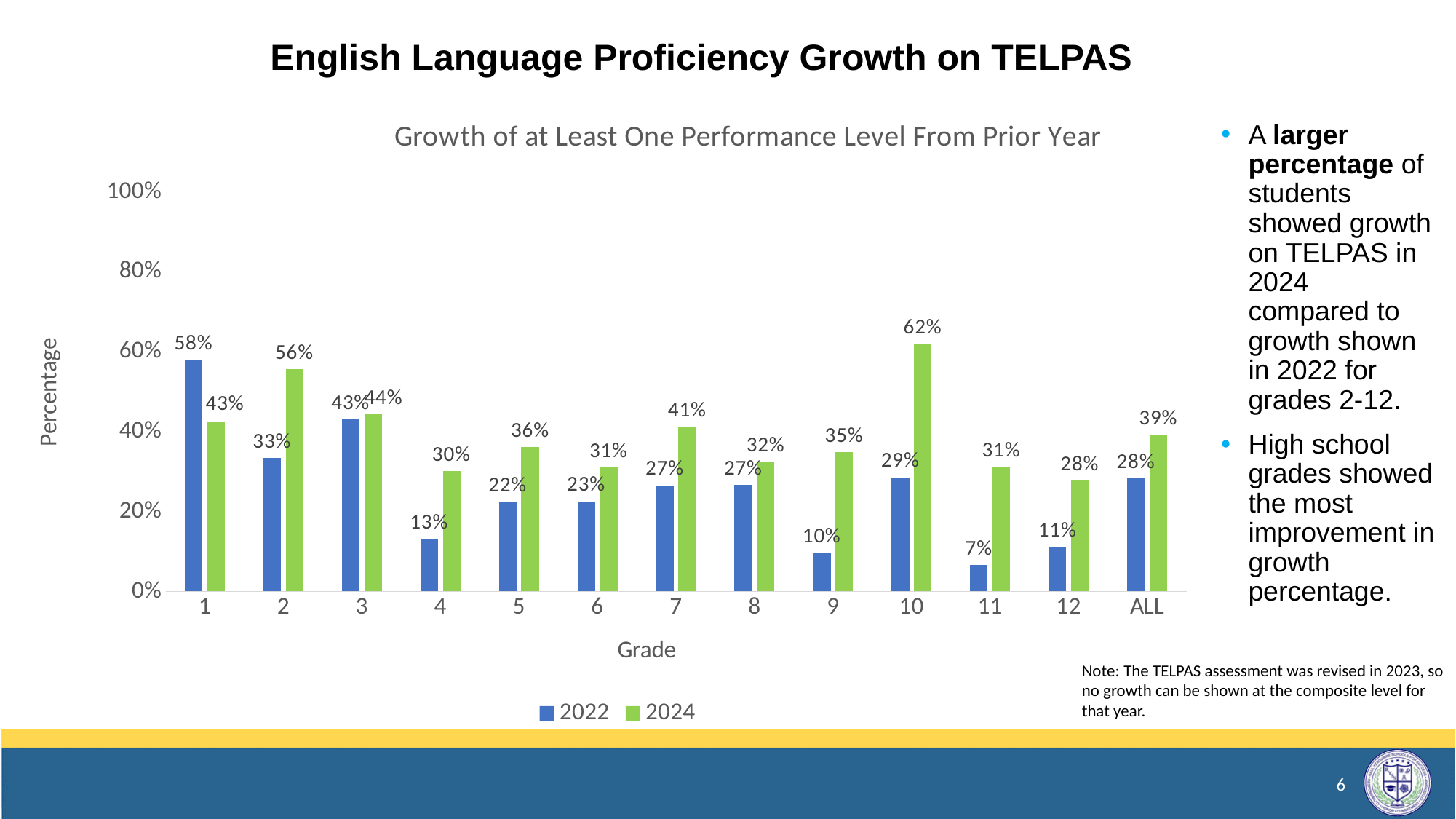
Which is larger for grade 1, the 2022 value or the 2024 value? 2022 Which grade has the highest 2024 value? 10 How many series does the legend list? 2 What is the 2024 value for grade 10? 62% What kind of chart is shown? Bar chart What is the title of the chart? Growth of at Least One Performance Level From Prior Year What is the difference between the 2024 and 2022 values for grade 10? 33 percentage points What is the 2024 value for the ALL category? 39% What is the 2022 value for grade 4? 13% Is the 2024 value for grade 2 greater or less than 40%? greater How many categories are shown on the x axis? 13 Which grade has the lowest 2022 value? 11